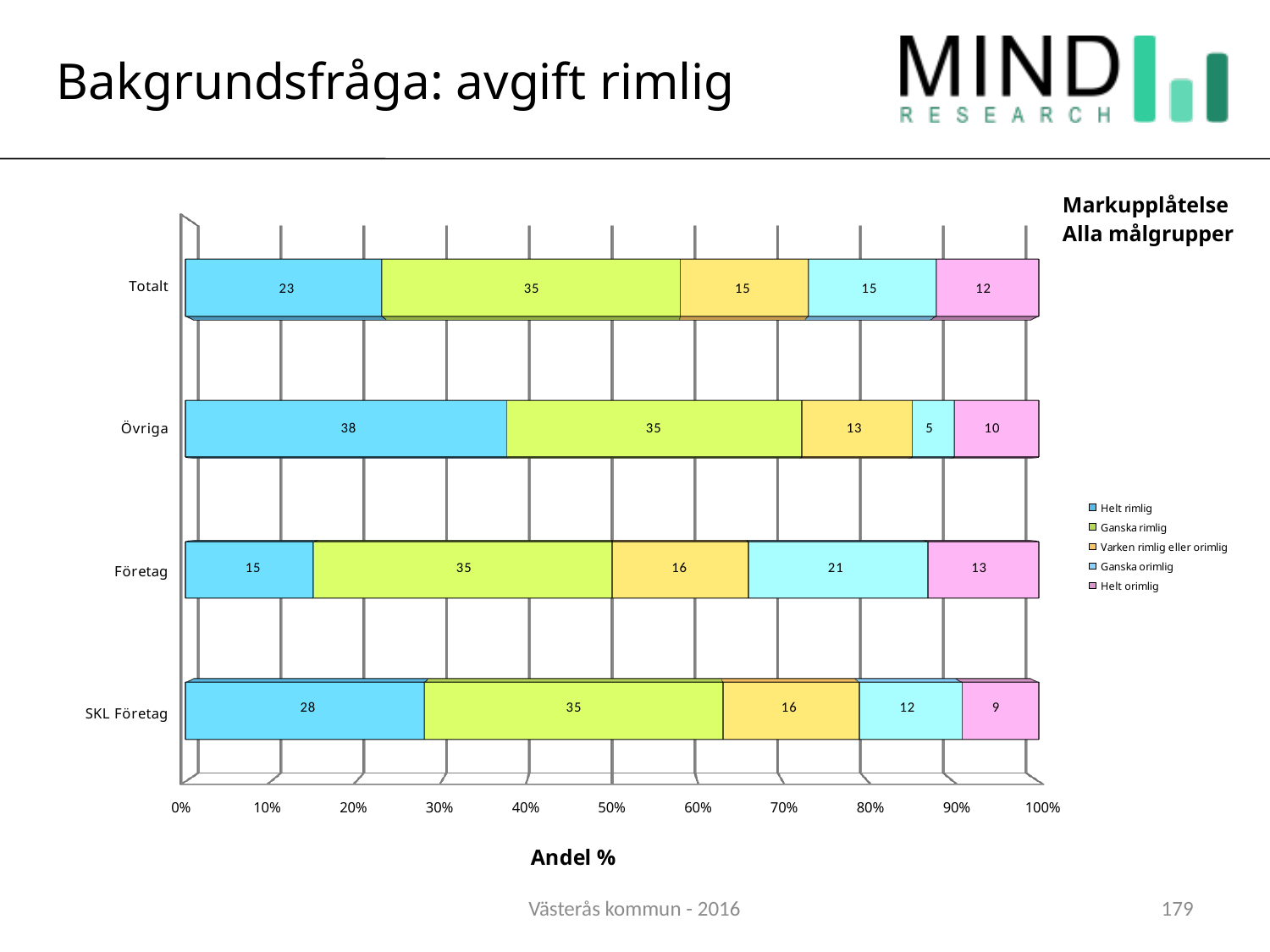
What is the difference between the "Helt rimlig" values for Övriga and Företag? 23 What is the label of the x axis? Andel % How many categories are shown on the y axis? 4 Which category has the lowest value for "Ganska orimlig"? Övriga Which is larger: "Varken rimlig eller orimlig" for Totalt or for Företag? Företag What is the total of the stacked bar for Övriga? 101 What is the value of "Helt orimlig" for SKL Företag? 9 Which category has the highest value for "Helt rimlig"? Övriga What kind of chart is shown on the slide? Stacked bar chart What is the value of "Ganska orimlig" for Företag? 21 What is the value of "Helt rimlig" for Övriga? 38 How many series does the legend list? 5